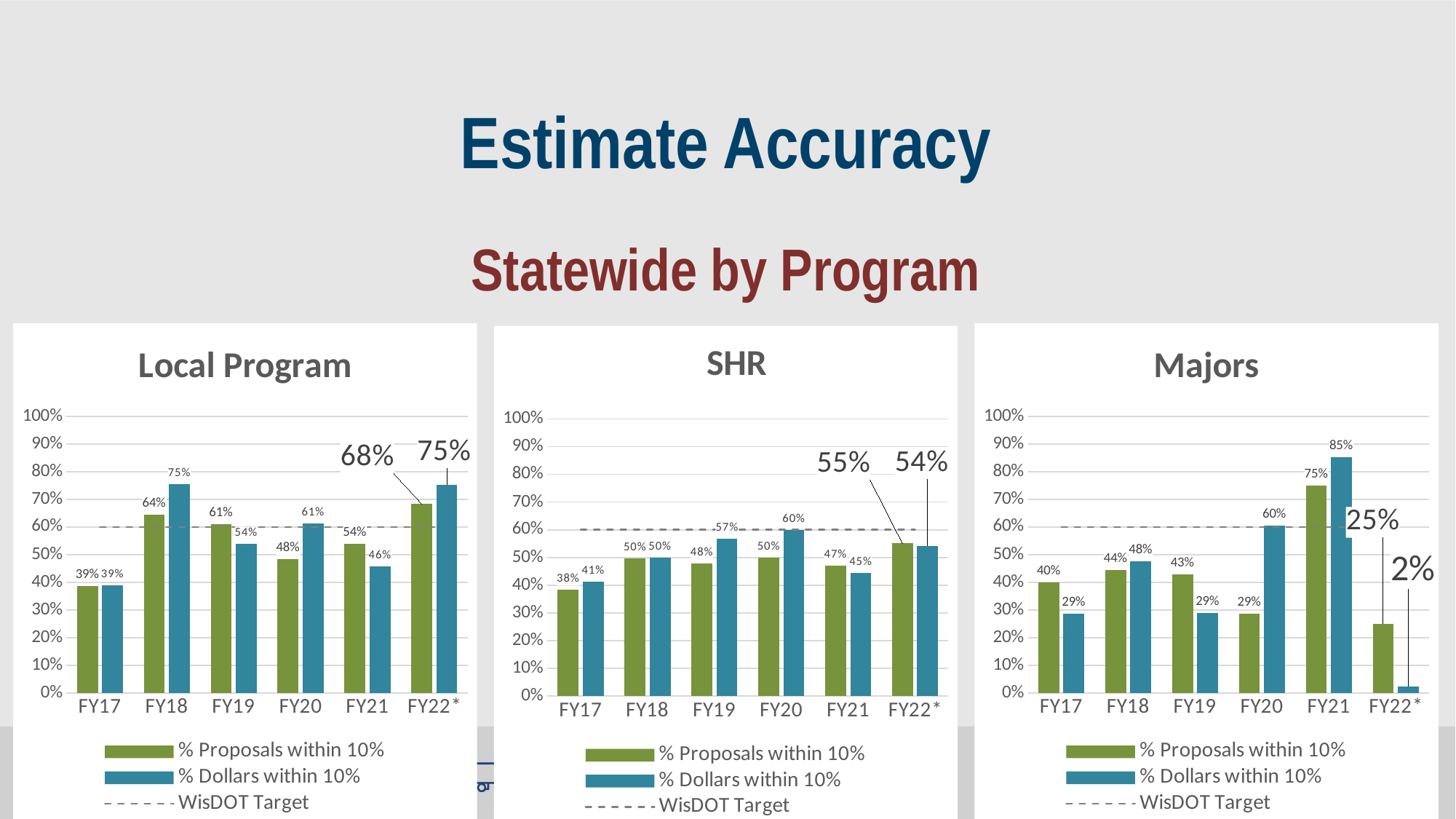
In the SHR chart, what is the % Dollars within 10% value for FY20? 60% In the Majors chart, which fiscal year has the highest % Dollars within 10% value? FY21 How many entries does the legend of the Majors chart list? 3 In the SHR chart, which fiscal year has the lowest % Proposals within 10% value? FY17 In the SHR chart, how many fiscal years are shown on the x axis? 6 In the Majors chart, what is the difference between the % Dollars within 10% and % Proposals within 10% values for FY21? 10% In the Local Program chart, which is larger for FY19: % Proposals within 10% or % Dollars within 10%? % Proposals within 10% What kind of chart is the SHR chart? Bar chart In the Majors chart, which fiscal year has the lowest % Dollars within 10% value? FY22* In the Local Program chart, what is the % Dollars within 10% value for FY18? 75% In the Local Program chart, what is the % Proposals within 10% value for FY22*? 68% In the Majors chart, what is the % Proposals within 10% value for FY20? 29%